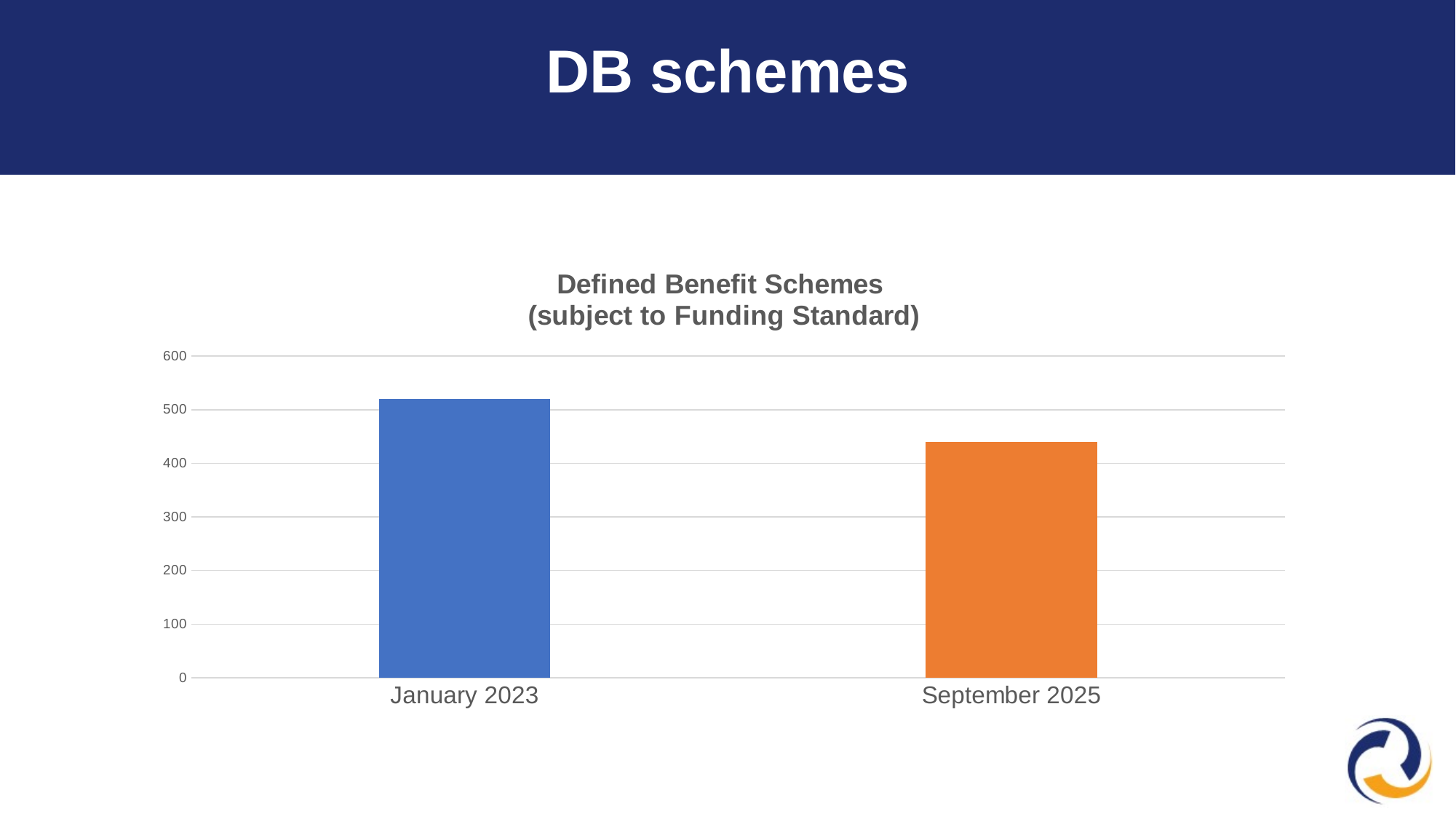
Do the values rise or fall from January 2023 to September 2025? fall Which category has the lowest value? September 2025 What kind of chart is shown on the slide? bar chart Is the value for January 2023 greater or less than 600? less Which category has the highest value? January 2023 What colour is the bar for September 2025? orange What is the title of the chart? Defined Benefit Schemes (subject to Funding Standard) Is the value for September 2025 greater or less than 500? less Which is larger, the value for January 2023 or the value for September 2025? January 2023 Is the value for January 2023 greater or less than 500? greater How many categories are plotted on the chart? 2